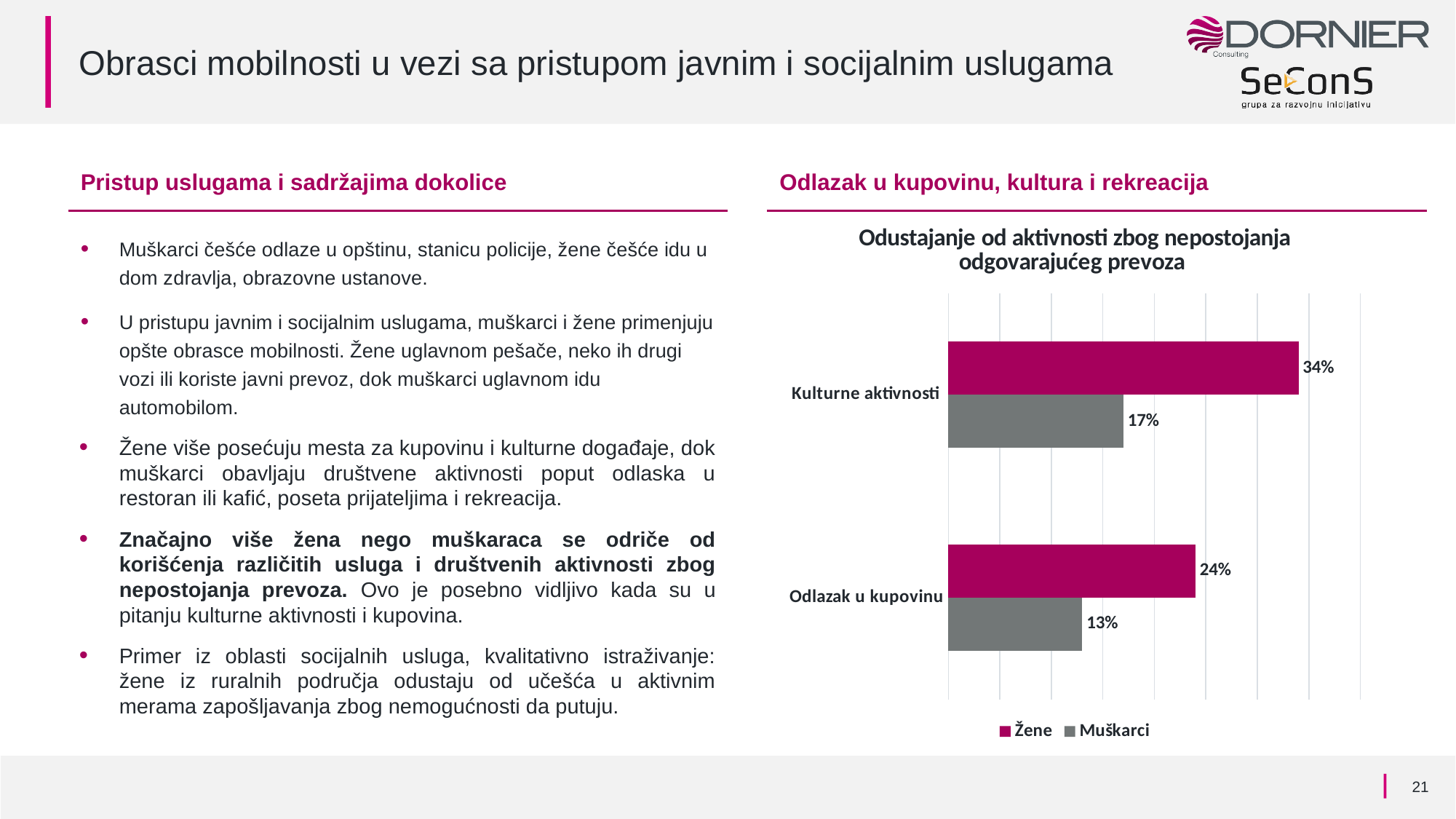
What is the value for Muškarci in the Odlazak u kupovinu category? 13% What is the difference between the Žene and Muškarci values for Kulturne aktivnosti? 17% What kind of chart is shown on the slide? Bar chart What is the value for Muškarci in the Kulturne aktivnosti category? 17% Which is larger for Odlazak u kupovinu: the Žene value or the Muškarci value? Žene How many series does the legend list? 2 What is the value for Žene in the Kulturne aktivnosti category? 34% Which category has the lowest value for Muškarci? Odlazak u kupovinu How many categories are shown on the chart? 2 What is the difference between the Žene and Muškarci values for Odlazak u kupovinu? 11% What is the value for Žene in the Odlazak u kupovinu category? 24% Which category has the highest value for Žene? Kulturne aktivnosti